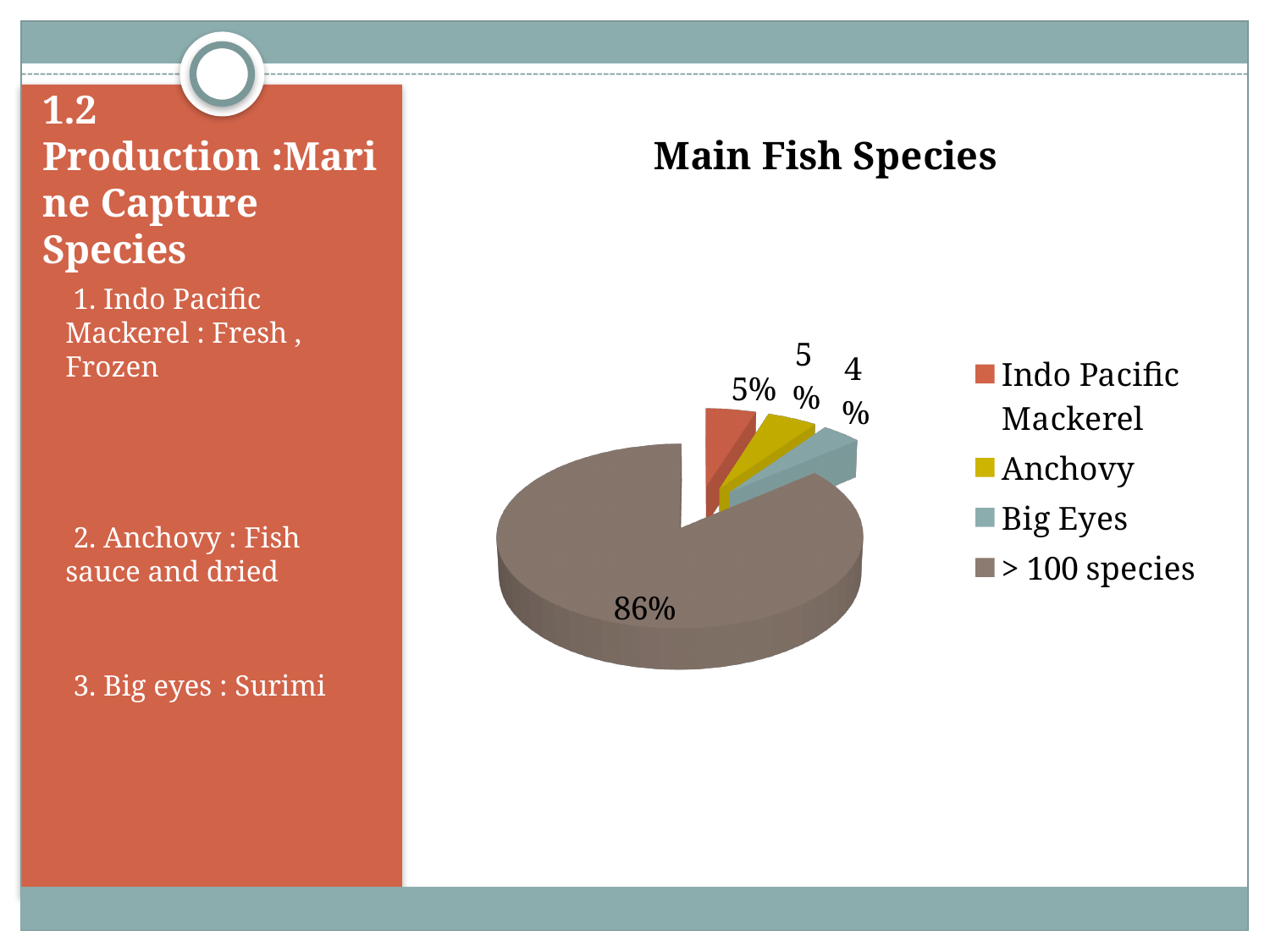
Which category has the largest slice of the pie? > 100 species What is the title of the chart? Main Fish Species What type of chart is shown on the slide? Pie chart What colour is the slice for '> 100 species'? Brown What share of the pie does Big Eyes represent? 4% What share of the pie does the '> 100 species' slice represent? 86% How many categories does the legend list? 4 What share of the pie does Indo Pacific Mackerel represent? 5% What is the difference between the share for '> 100 species' and the share for Indo Pacific Mackerel? 81% Which category has the smallest slice of the pie? Big Eyes Which is larger, the share for Anchovy or the share for Big Eyes? Anchovy What share of the pie does Anchovy represent? 5%